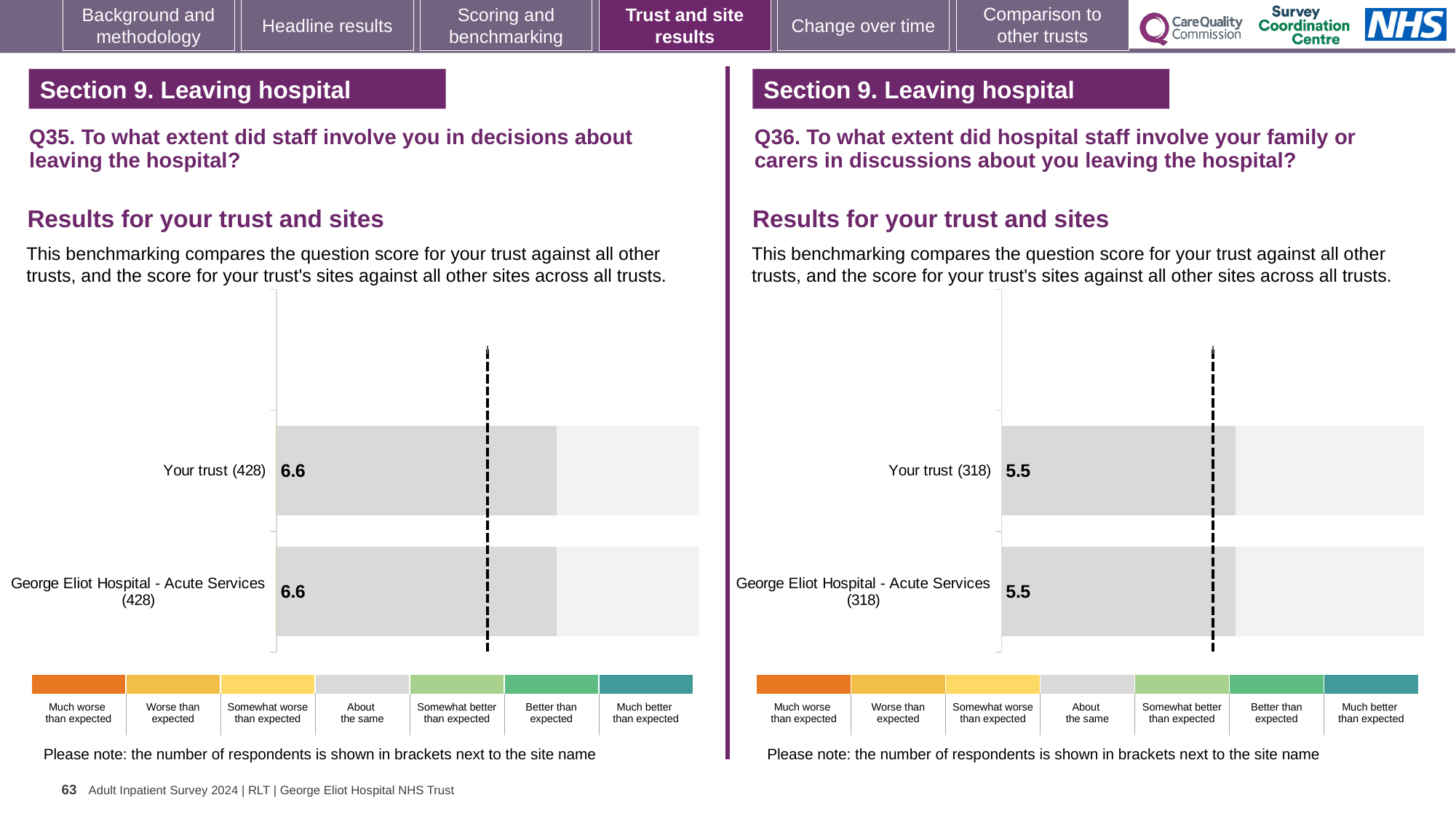
On the Q35 chart (left), what is the score for George Eliot Hospital - Acute Services? 6.6 On the Q35 chart (left), what is the difference between the score for Your trust and the score for George Eliot Hospital - Acute Services? 0 On the Q36 chart (right), what is the score for George Eliot Hospital - Acute Services? 5.5 Is the score for Your trust on the Q36 chart (right) greater or less than the score for Your trust on the Q35 chart (left)? less On the Q35 chart (left), what is the score for Your trust? 6.6 On the Q36 chart (right), what is the score for Your trust? 5.5 How many bars are plotted on the Q36 chart (right)? 2 How many bars are plotted on the Q35 chart (left)? 2 On the Q36 chart (right), what is the difference between the score for Your trust and the score for George Eliot Hospital - Acute Services? 0 On the Q35 chart (left), how many respondents are shown in brackets next to Your trust? 428 On the Q36 chart (right), how many respondents are shown in brackets next to George Eliot Hospital - Acute Services? 318 What kind of chart is used on the Q35 chart (left)? Bar chart